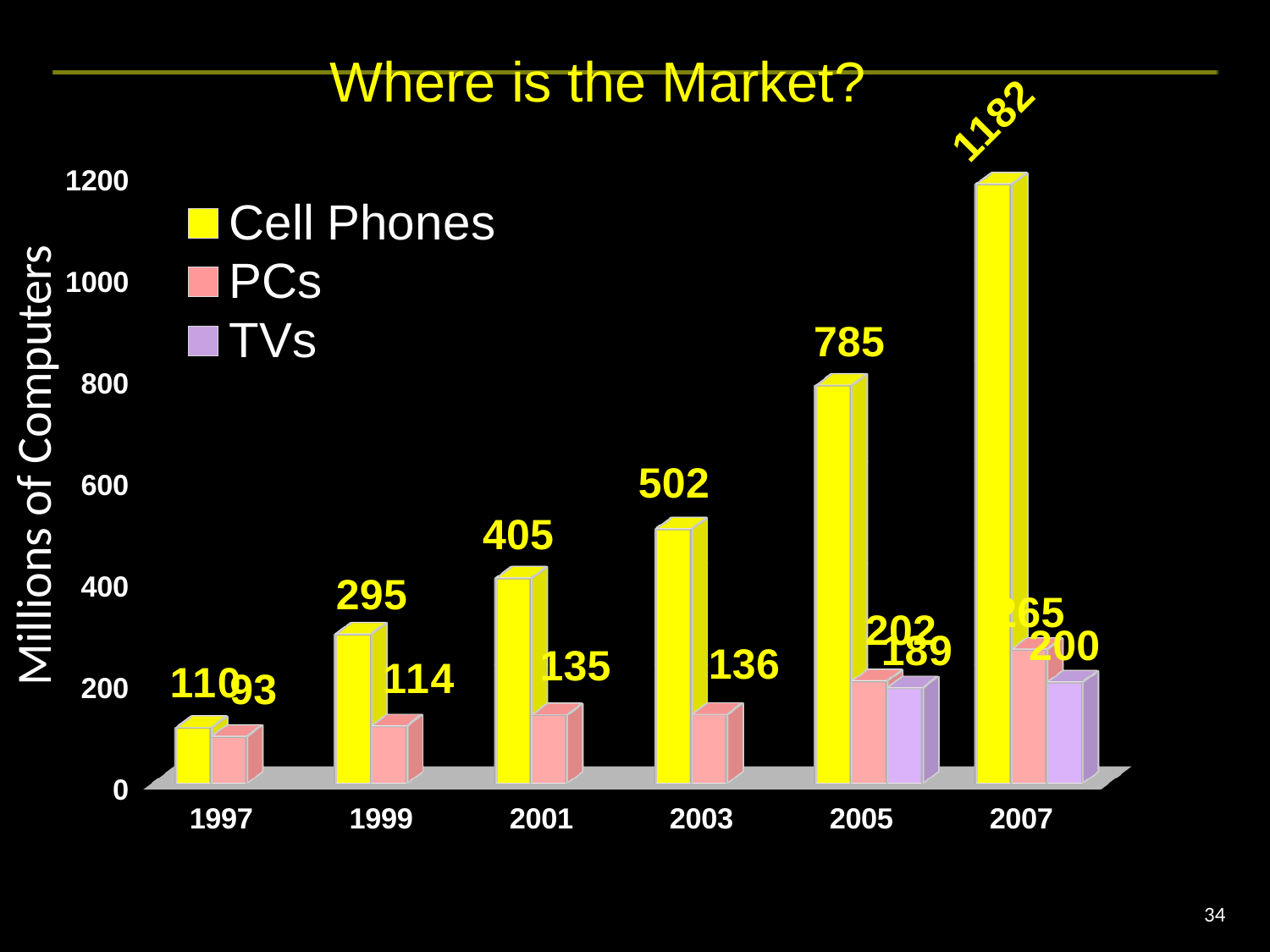
Do the Cell Phones values rise or fall from 1997 to 2007? rise How many series does the legend list? 3 How many years are shown on the x axis? 6 What is the value for TVs in 2005? 189 What is the difference between the Cell Phones values for 2005 and 2003? 283 What is the value for Cell Phones in 2003? 502 Is the Cell Phones value for 2005 greater or less than 600? greater Which is larger in 2005, the PCs value or the TVs value? PCs What is the value for PCs in 2001? 135 What is the value for Cell Phones in 2007? 1182 In which year is the Cell Phones value highest? 2007 In which year is the Cell Phones value lowest? 1997